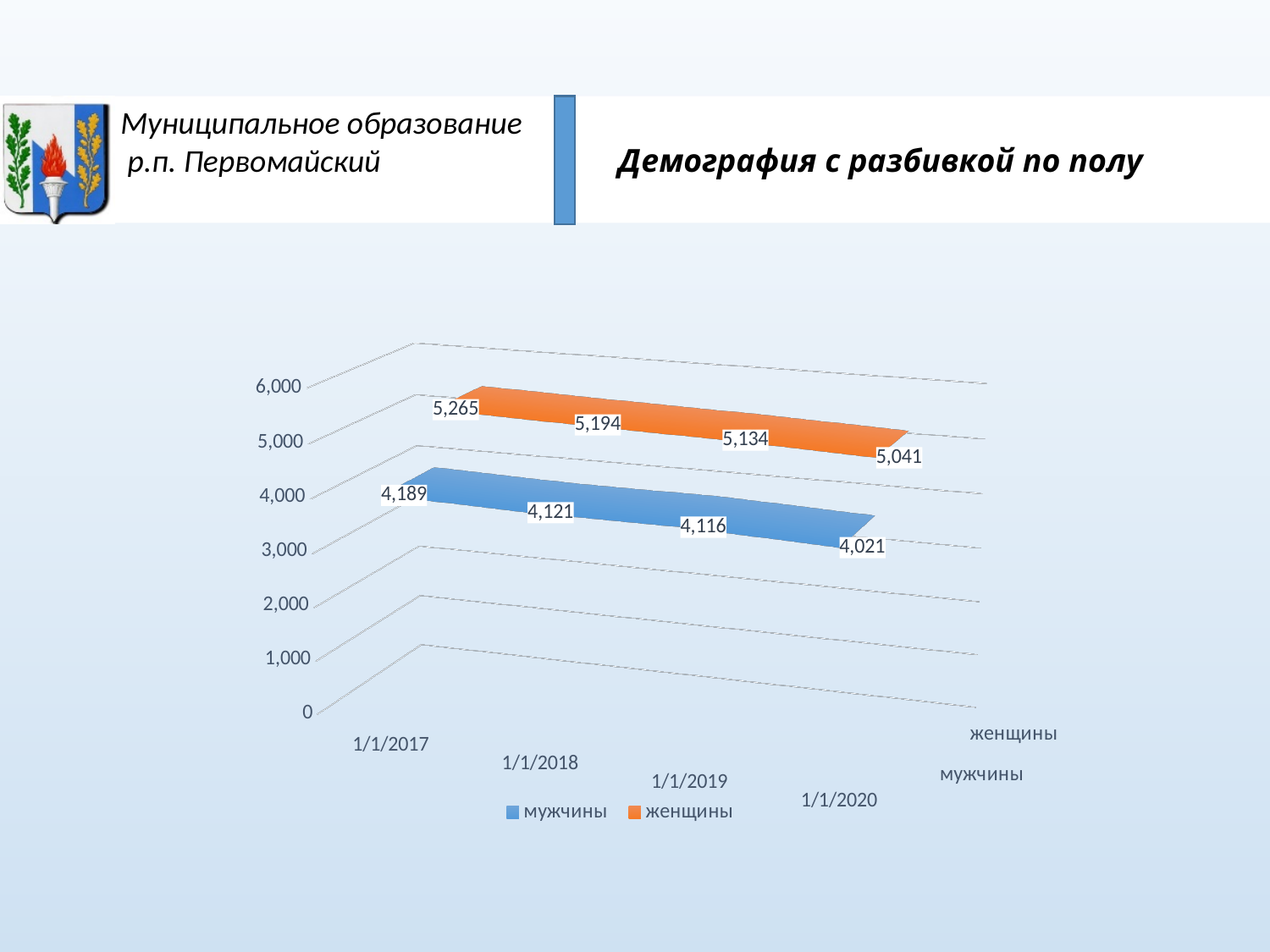
What is the difference between женщины and мужчины on 1/1/2017? 1,076 Which is larger on 1/1/2019: the value for мужчины or for женщины? женщины What is the value for женщины on 1/1/2018? 5,194 On which date is the value for женщины highest? 1/1/2017 What is the value for мужчины on 1/1/2019? 4,116 Do the values for женщины rise or fall from 1/1/2017 to 1/1/2020? fall How many series does the legend list? 2 What is the value for женщины on 1/1/2020? 5,041 What is the difference between the мужчины value on 1/1/2017 and on 1/1/2020? 168 On which date is the value for мужчины lowest? 1/1/2020 What is the value for мужчины on 1/1/2017? 4,189 How many dates are shown on the x axis? 4